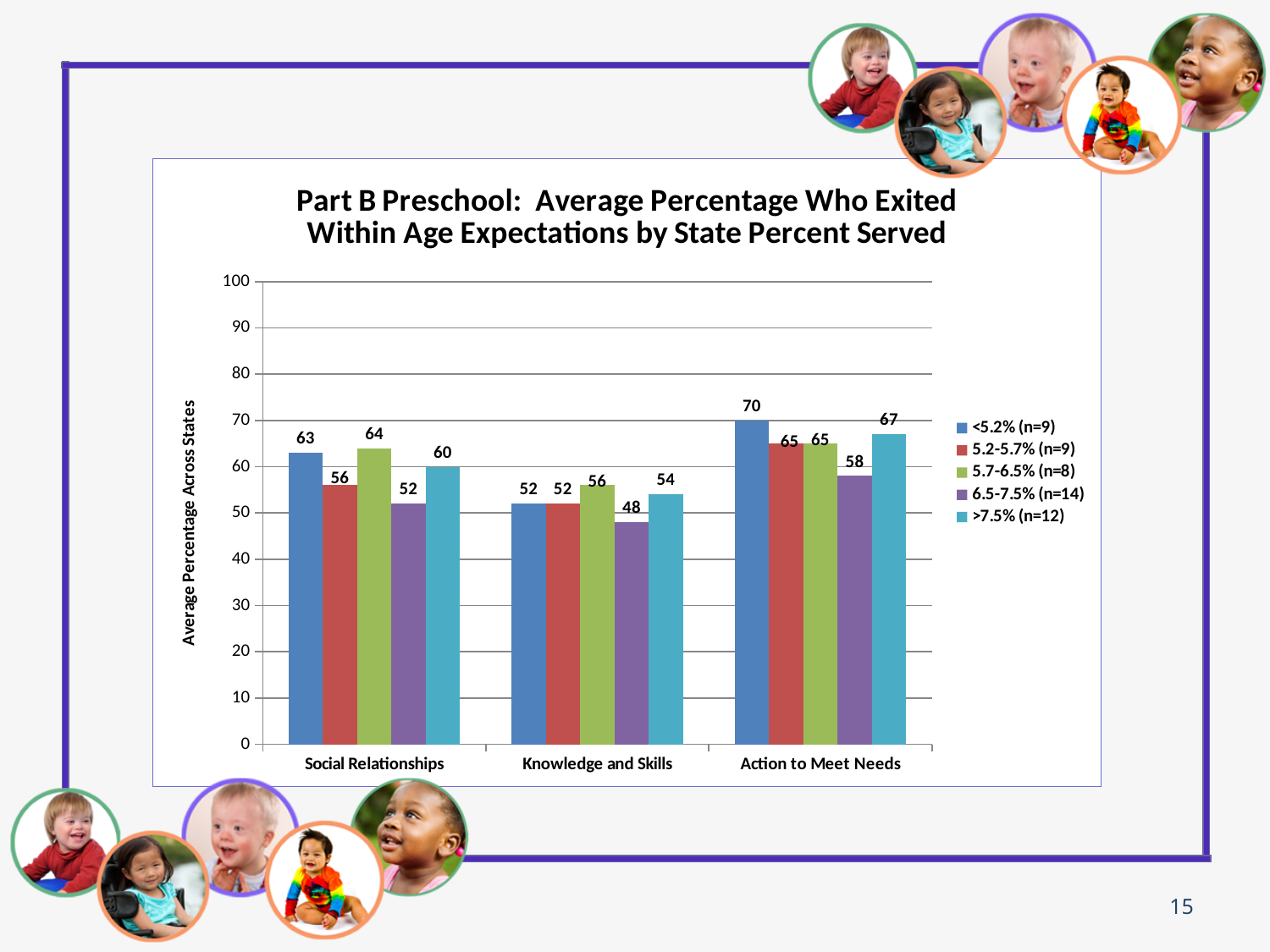
What is the value for the <5.2% (n=9) series in the Action to Meet Needs category? 70 What kind of chart is shown on the slide? Bar chart Which series has the highest value in the Social Relationships category? 5.7-6.5% (n=8) Which is larger in the Social Relationships category: the 5.2-5.7% (n=9) value or the >7.5% (n=12) value? >7.5% (n=12) Which series has the lowest value in the Knowledge and Skills category? 6.5-7.5% (n=14) What is the value for the >7.5% (n=12) series in the Social Relationships category? 60 Which category has the highest value for the 5.7-6.5% (n=8) series? Action to Meet Needs What is the value for the 6.5-7.5% (n=14) series in the Knowledge and Skills category? 48 How many series does the legend list? 5 What is the difference between the <5.2% (n=9) value and the 6.5-7.5% (n=14) value in the Action to Meet Needs category? 12 What is the label of the vertical axis? Average Percentage Across States How many categories are shown on the x axis? 3